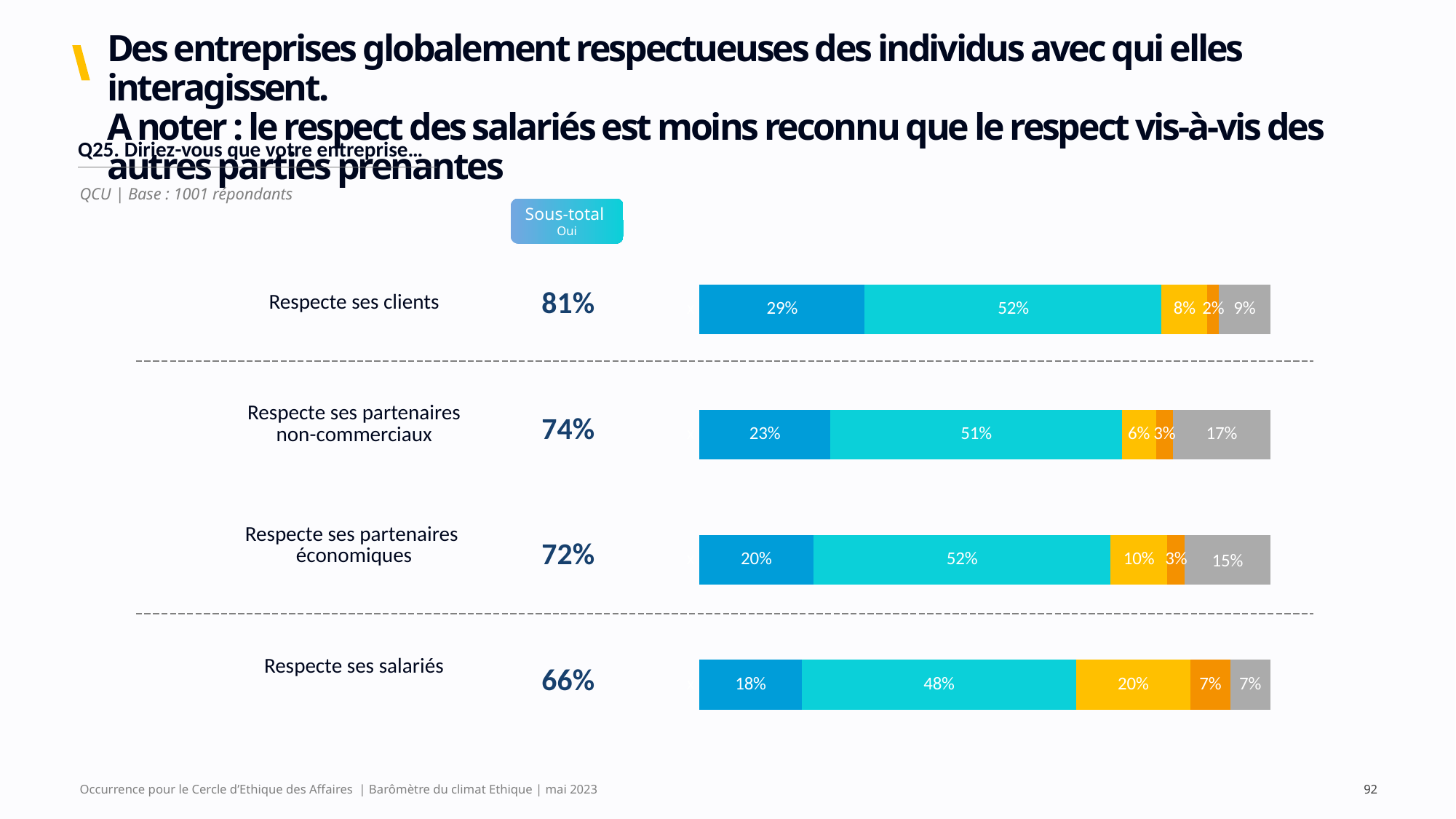
Which has the larger cyan (second) segment: "Respecte ses clients" or "Respecte ses salariés"? Respecte ses clients What is the value of the grey segment of the bar for "Respecte ses partenaires non-commerciaux"? 17% What is the value of the first (dark blue) segment of the bar for "Respecte ses partenaires économiques"? 20% What is the label shown above the column of bold percentages to the left of the bars? Sous-total Oui What is the Sous-total Oui value for "Respecte ses salariés"? 66% How many categories (bars) are shown in the chart? 4 Which category has the highest Sous-total Oui? Respecte ses clients Which category has the lowest Sous-total Oui? Respecte ses salariés What is the value of the yellow segment of the bar for "Respecte ses salariés"? 20% What is the difference in percentage points between the Sous-total Oui for "Respecte ses clients" and for "Respecte ses salariés"? 15 points What kind of chart is shown on the slide? Stacked bar chart What is the Sous-total Oui value for "Respecte ses clients"? 81%